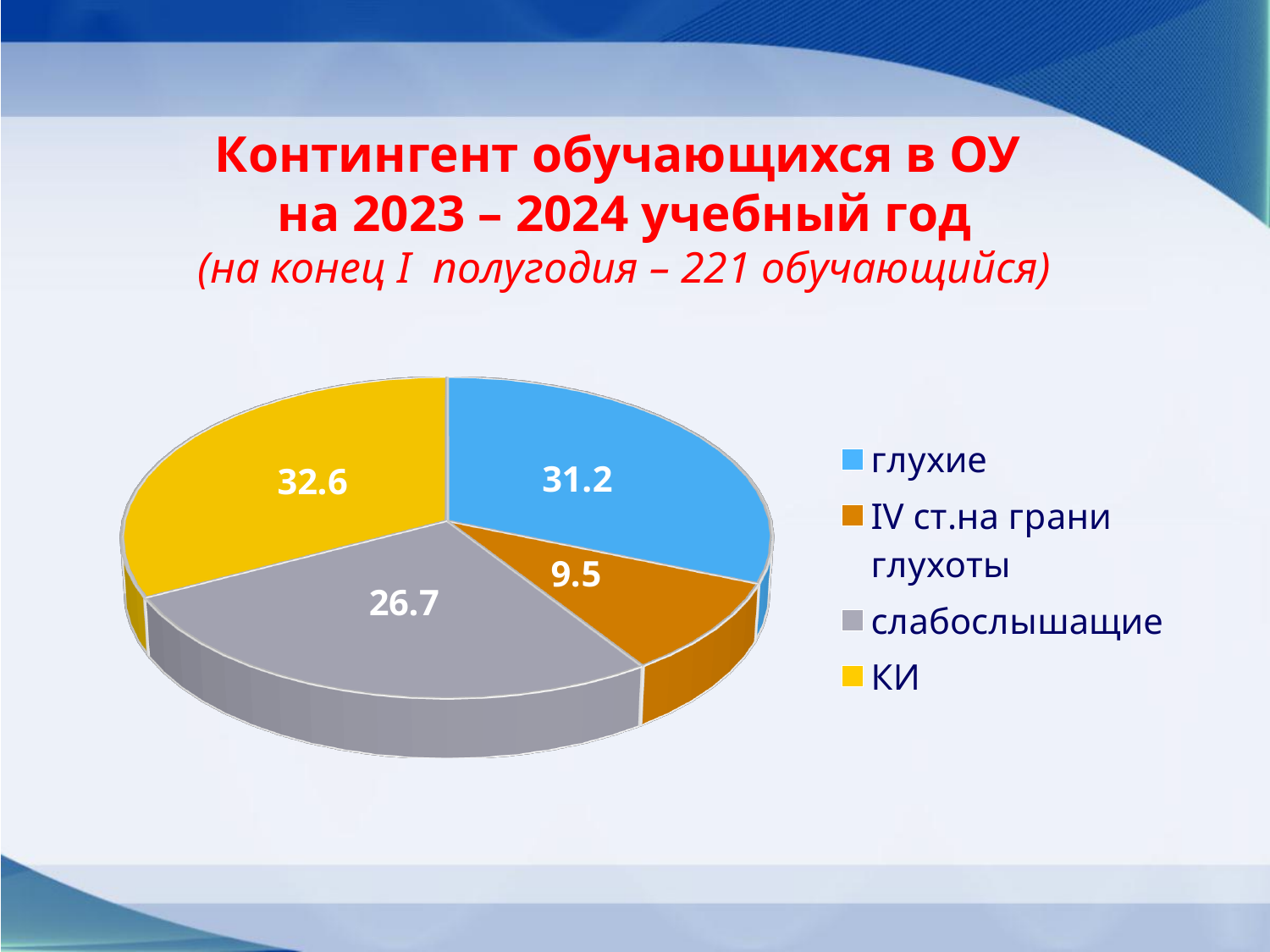
What type of chart is shown on the slide? Pie chart What is the value shown for the слабослышащие slice? 26.7 What is the value shown for the глухие slice? 31.2 What is the value shown for the КИ slice? 32.6 How many categories does the pie chart have? 4 Which is larger, the value for глухие or the value for слабослышащие? глухие What is the difference between the values for слабослышащие and IV ст.на грани глухоты? 17.2 What is the difference between the values for КИ and глухие? 1.4 Which category has the smallest slice of the pie? IV ст.на грани глухоты What colour is the слабослышащие slice? Grey Which category has the largest slice of the pie? КИ What is the value shown for the IV ст.на грани глухоты slice? 9.5